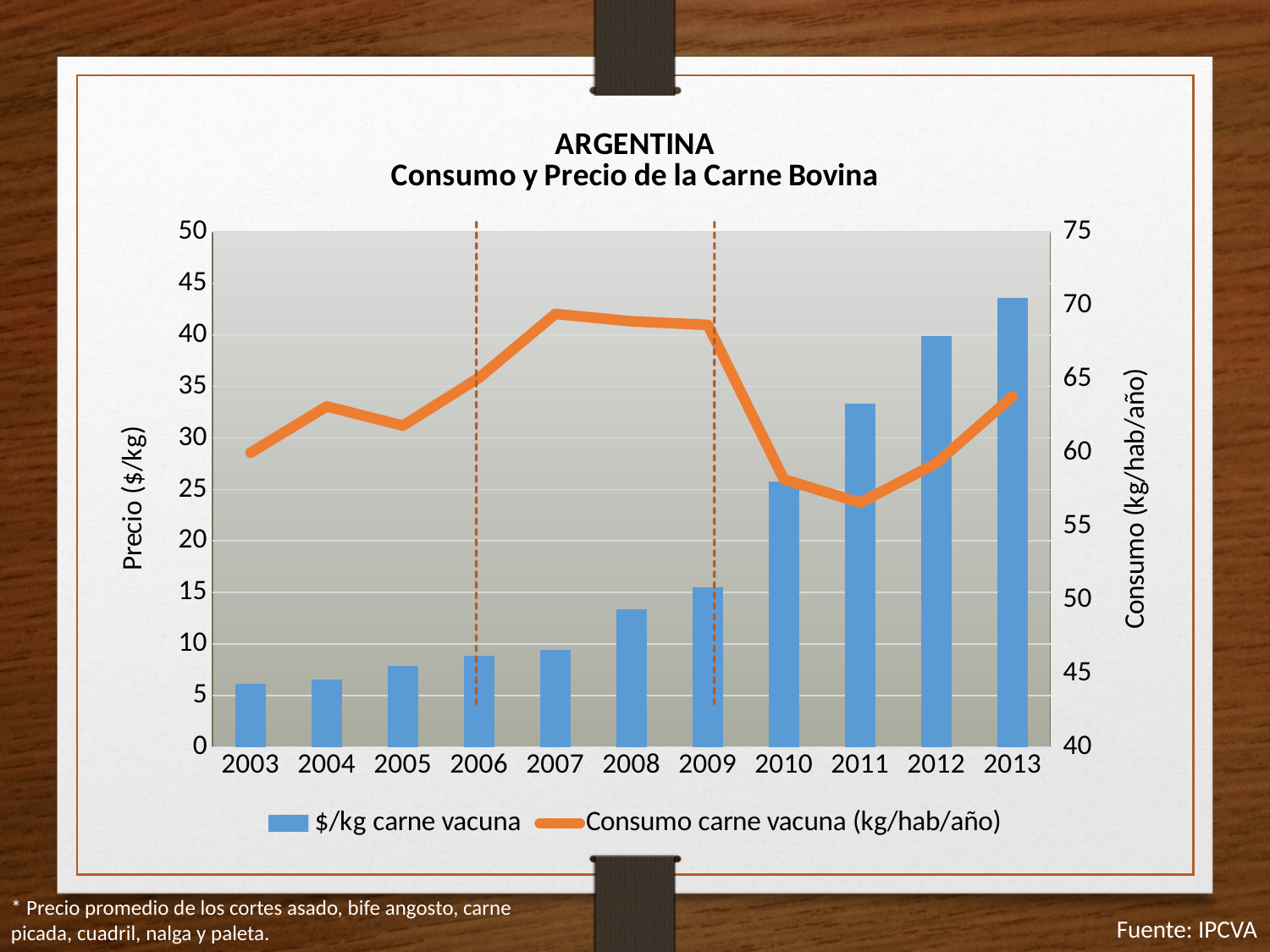
Is the Consumo carne vacuna value for 2007 greater or less than 65 kg/hab/año? greater In which year is the bar for $/kg carne vacuna the highest? 2013 Is the $/kg carne vacuna value for 2010 greater or less than 30? less What kind of chart is shown on the slide? A combined bar and line chart Do the $/kg carne vacuna bars generally rise or fall from 2003 to 2013? rise How many series does the legend list? 2 In which year does the Consumo carne vacuna line reach its highest point? 2007 Which year has a higher $/kg carne vacuna bar, 2010 or 2011? 2011 In which year does the Consumo carne vacuna line reach its lowest point? 2011 Is the $/kg carne vacuna value for 2012 greater or less than 35? greater How many years are shown on the x axis of the chart? 11 In which year is the bar for $/kg carne vacuna the lowest? 2003